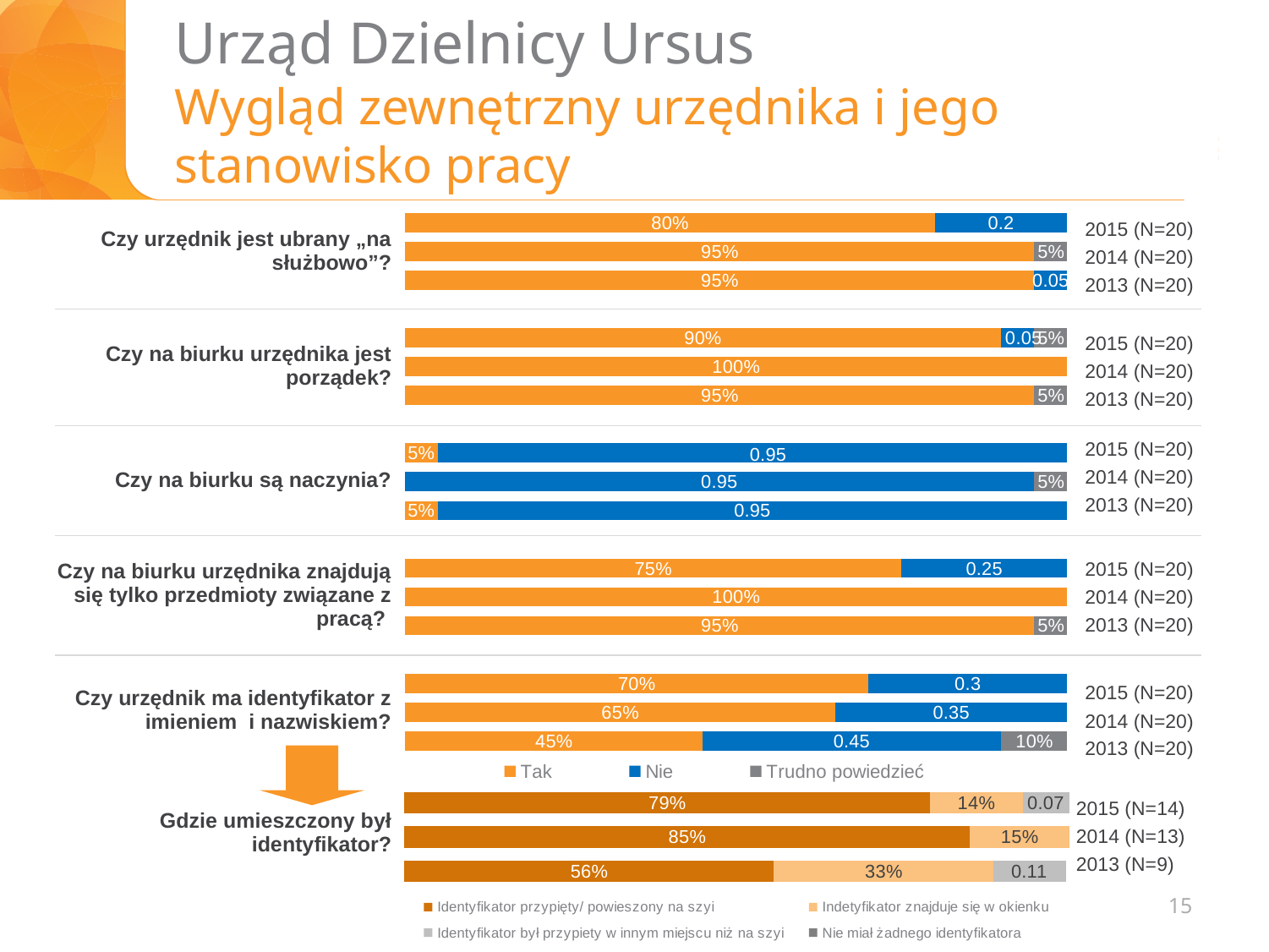
In the chart "Czy na biurku są naczynia?", what is the "Nie" value for 2014 (N=20)? 0.95 What type of chart is used for "Gdzie umieszczony był identyfikator?"? stacked bar chart In the chart "Gdzie umieszczony był identyfikator?", how many series does the legend list? 4 In the chart "Czy na biurku urzędnika jest porządek?", what is the "Tak" value for 2014 (N=20)? 100% In the chart "Czy urzędnik ma identyfikator z imieniem i nazwiskiem?", does the "Tak" value rise or fall from 2013 to 2015? rise In the chart "Czy na biurku urzędnika znajdują się tylko przedmioty związane z pracą?", what is the "Tak" value for 2015 (N=20)? 75% In the chart "Czy urzędnik jest ubrany „na służbowo”?", what is the "Nie" value for 2015 (N=20)? 0.2 In the chart "Czy na biurku urzędnika znajdują się tylko przedmioty związane z pracą?", what is the difference between the "Tak" values for 2014 (N=20) and 2015 (N=20)? 25% In the chart "Czy urzędnik ma identyfikator z imieniem i nazwiskiem?", what is the "Tak" value for 2013 (N=20)? 45% In the chart "Gdzie umieszczony był identyfikator?", what is the value for "Identyfikator przypięty/ powieszony na szyi" in 2014 (N=13)? 85% In the chart "Czy urzędnik jest ubrany „na służbowo”?", what is the "Tak" value for 2015 (N=20)? 80% In the chart "Czy na biurku urzędnika jest porządek?", which year has the lowest "Tak" value? 2015 (N=20)